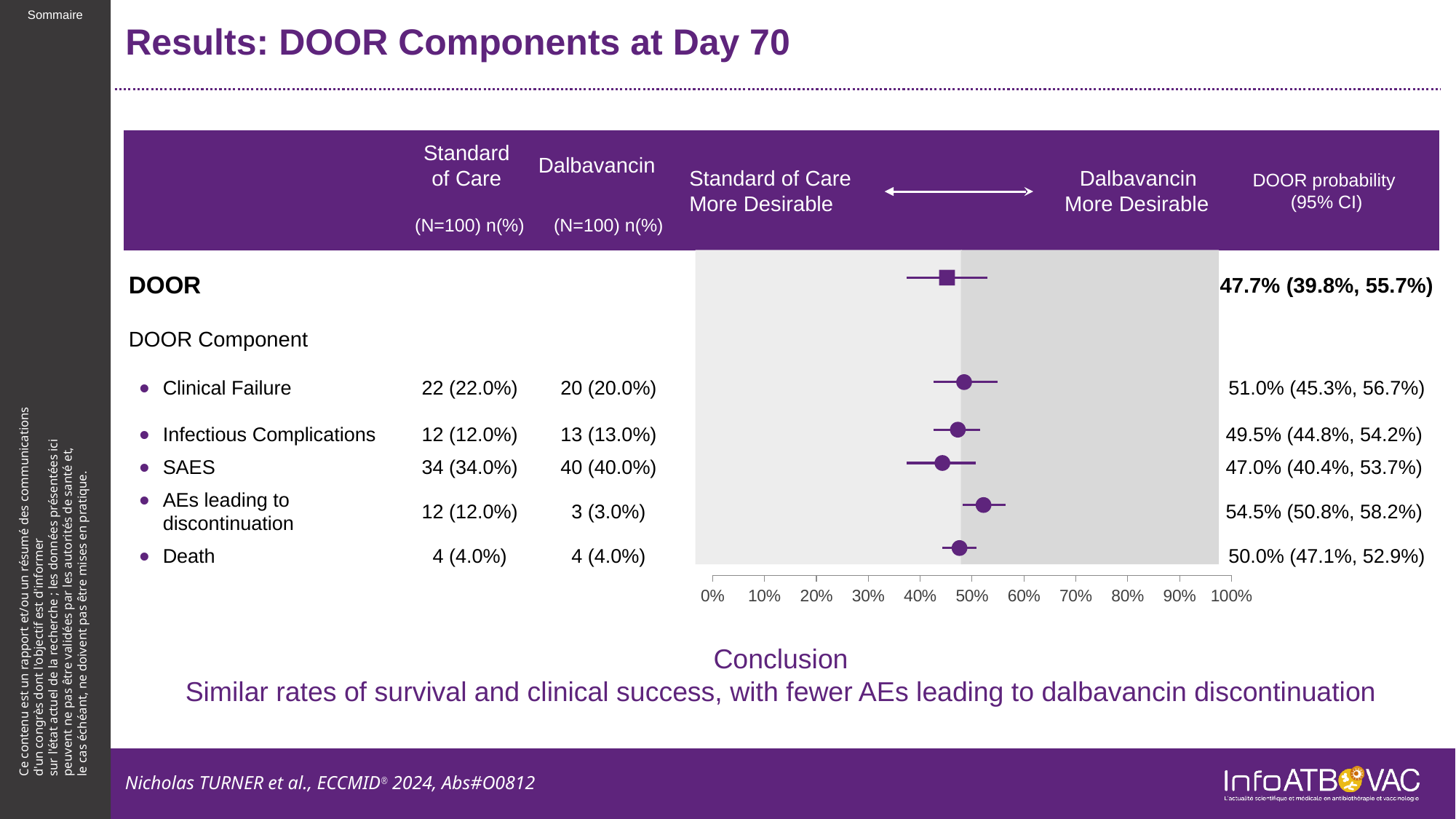
Which DOOR component has the highest DOOR probability? AEs leading to discontinuation What is the range of the x axis of the plot? 0% to 100% What is the DOOR probability (95% CI) for AEs leading to discontinuation? 54.5% (50.8%, 58.2%) What kind of chart is used to display the DOOR probabilities? Forest plot What is the DOOR probability for SAES? 47.0% Which DOOR component has the lowest DOOR probability? SAES How many DOOR components are listed under 'DOOR Component'? 5 What is the overall DOOR probability (95% CI) shown at the top of the plot? 47.7% (39.8%, 55.7%) How many Standard of Care patients had SAES, as shown in the table? 34 (34.0%) What is the difference in DOOR probability between AEs leading to discontinuation and SAES? 7.5 percentage points Is the plotted DOOR probability for AEs leading to discontinuation greater or less than 50%? greater Which has a higher DOOR probability, Clinical Failure or Death? Clinical Failure